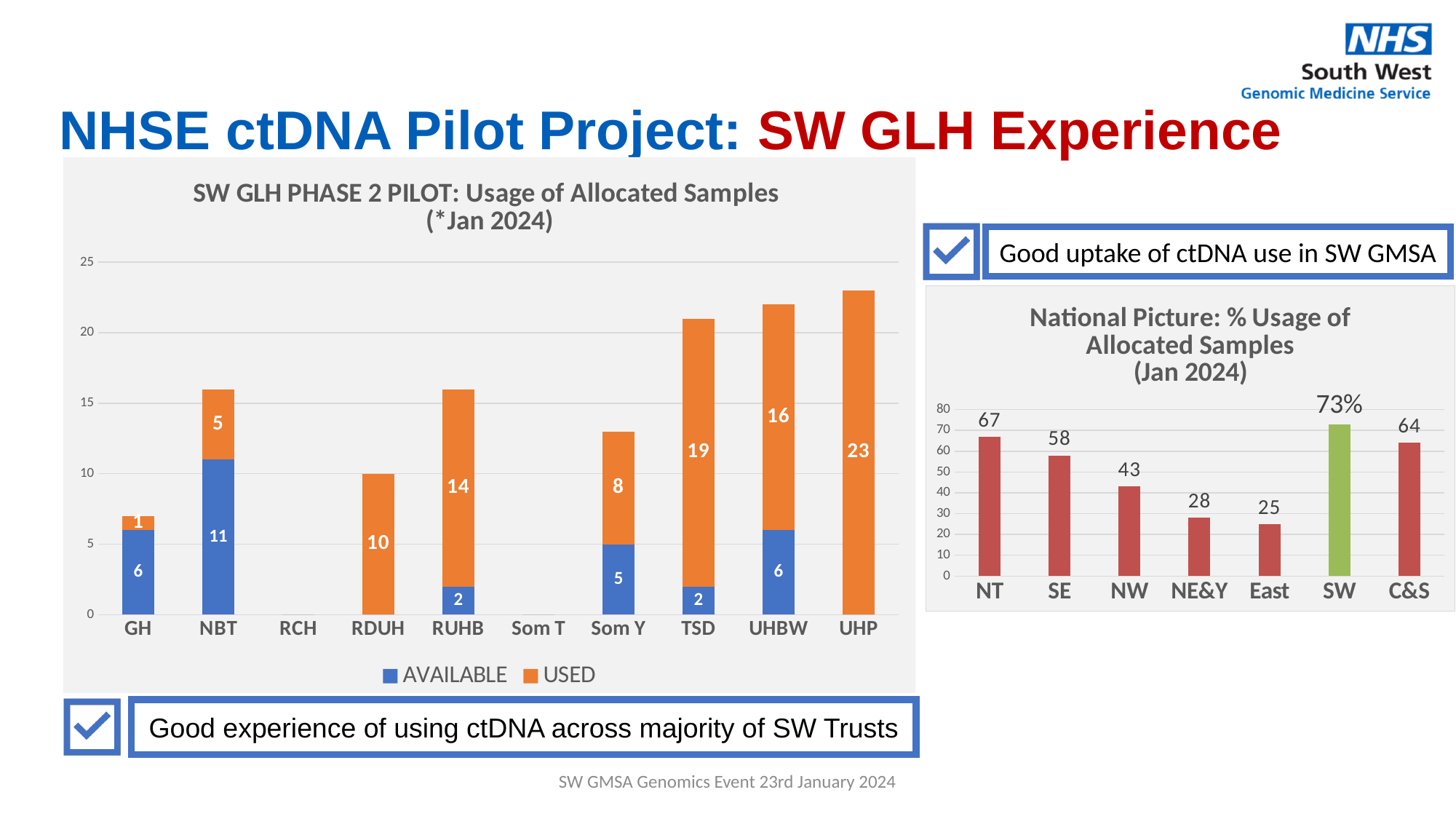
In the 'SW GLH PHASE 2 PILOT: Usage of Allocated Samples' chart, how many series does the legend list? 2 In the 'National Picture: % Usage of Allocated Samples' chart, which region has the highest value? SW In the 'SW GLH PHASE 2 PILOT: Usage of Allocated Samples' chart, which trust has the largest USED value? UHP In the 'National Picture: % Usage of Allocated Samples' chart, what is the value for SW? 73% In the 'SW GLH PHASE 2 PILOT: Usage of Allocated Samples' chart, what is the USED value for TSD? 19 In the 'National Picture: % Usage of Allocated Samples' chart, how many regions are shown? 7 In the 'SW GLH PHASE 2 PILOT: Usage of Allocated Samples' chart, what is the total height of the stacked bar for UHBW? 22 In the 'National Picture: % Usage of Allocated Samples' chart, what is the difference between NT and SE? 9 In the 'National Picture: % Usage of Allocated Samples' chart, what is the value for NE&Y? 28 In the 'SW GLH PHASE 2 PILOT: Usage of Allocated Samples' chart, what is the AVAILABLE value for NBT? 11 In the 'National Picture: % Usage of Allocated Samples' chart, which region has the lowest value? East What kind of chart is the 'SW GLH PHASE 2 PILOT: Usage of Allocated Samples' chart? Stacked bar chart